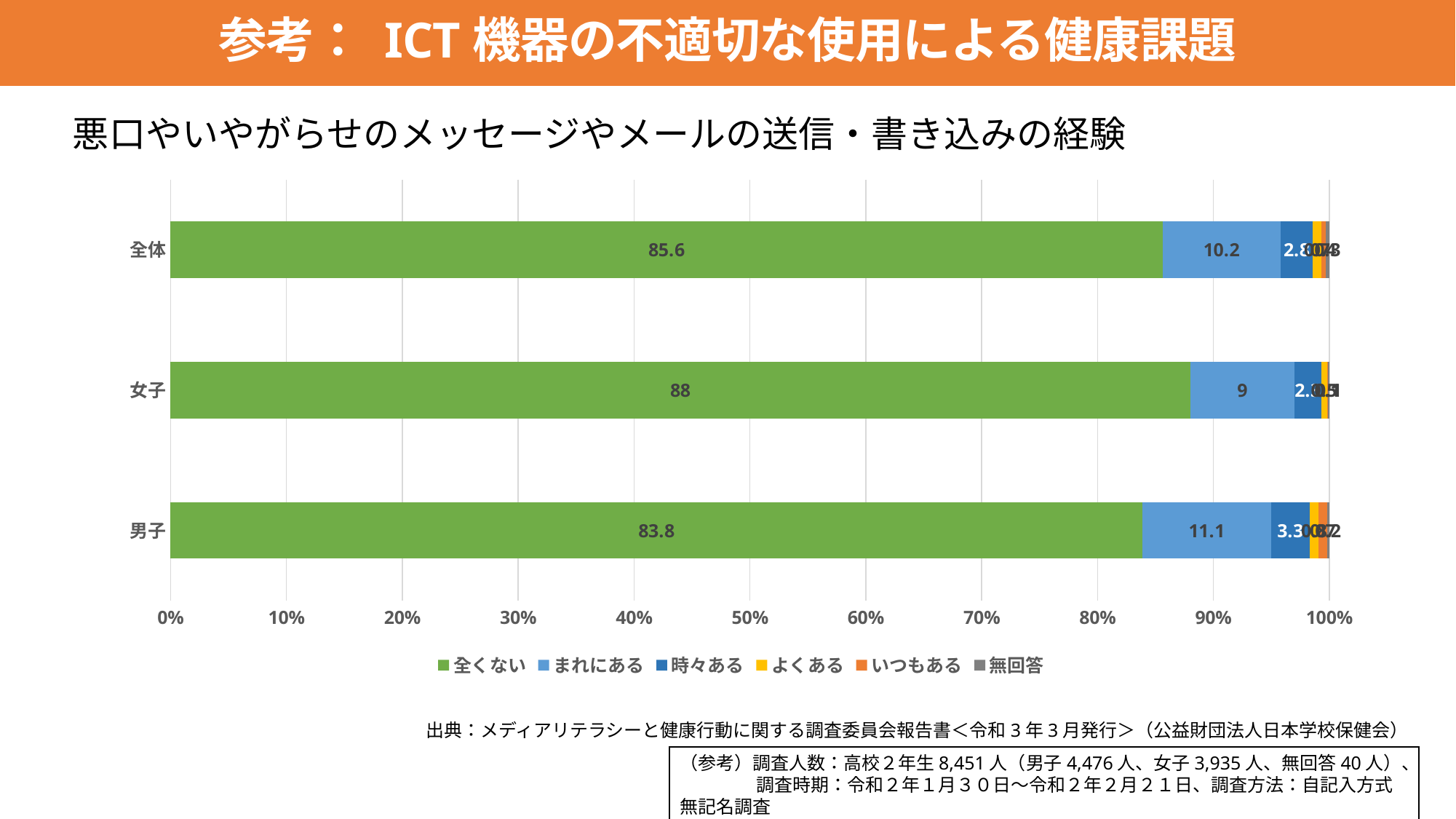
What is the value of まれにある for 男子? 11.1 How many categories (bars) does the chart show? 3 What is the value of 時々ある for 女子? 2.3 Which category has the lowest value for まれにある? 女子 What is the value of 全くない for 女子? 88 Which category has the highest value for 全くない? 女子 What is the value of 全くない for 男子? 83.8 How many series does the legend list? 6 Which is larger, the 時々ある value for 男子 or for 全体? 男子 What is the difference between the 全くない values for 女子 and 男子? 4.2 What kind of chart is shown on the slide? Stacked bar chart What is the value of 全くない for 全体? 85.6